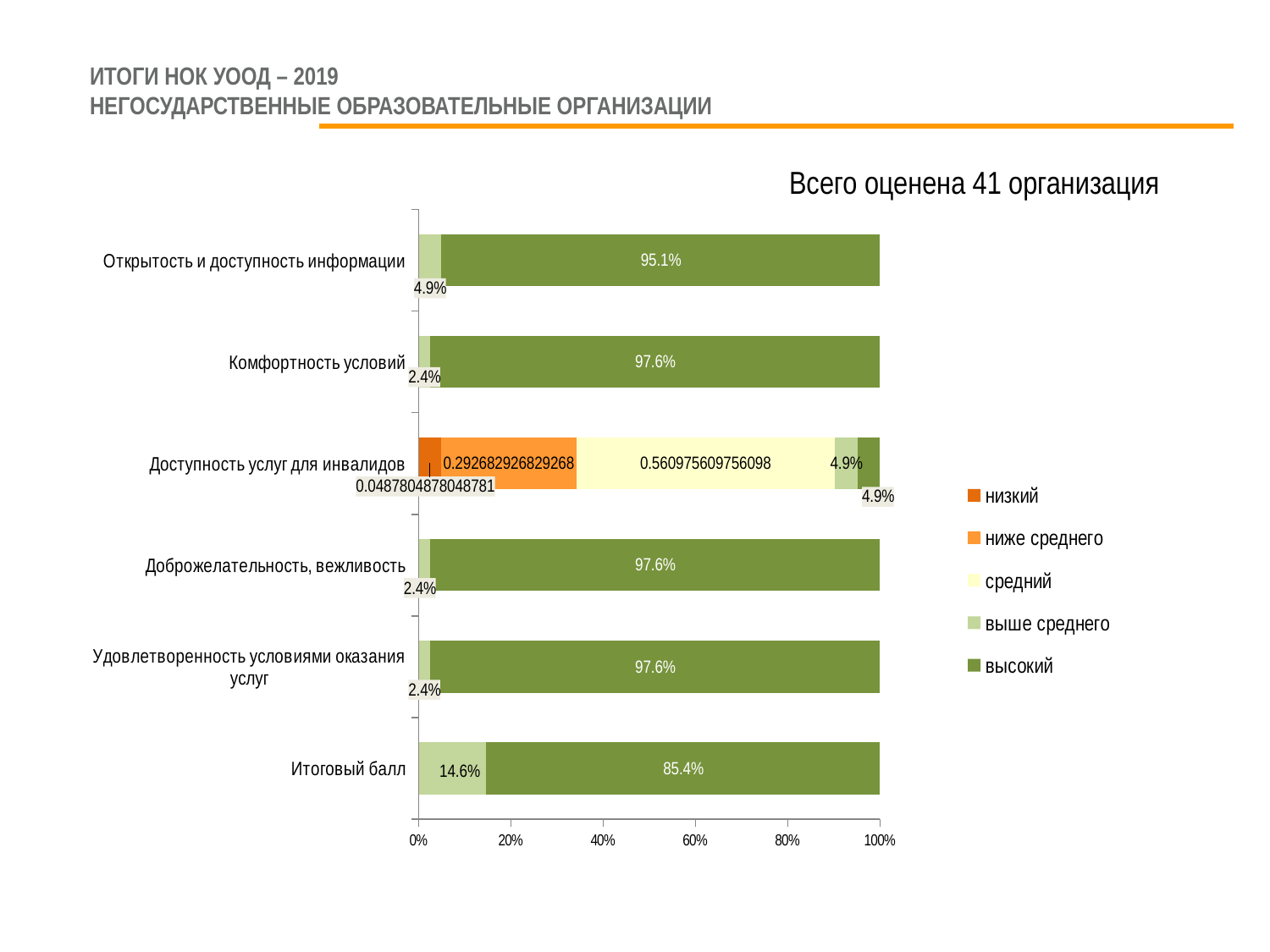
What is the value of the 'высокий' series for 'Комфортность условий'? 97.6% What is the value of the 'средний' series for 'Доступность услуг для инвалидов'? 0.560975609756098 What kind of chart is shown on the slide? stacked bar chart How many series does the legend list? 5 What is the value of the 'выше среднего' series for 'Итоговый балл'? 14.6% How many categories are plotted on the chart? 6 What is the value of the 'высокий' series for 'Открытость и доступность информации'? 95.1% Which is larger: the 'высокий' value for 'Открытость и доступность информации' or for 'Доброжелательность, вежливость'? Доброжелательность, вежливость What is the value of the 'ниже среднего' series for 'Доступность услуг для инвалидов'? 0.292682926829268 Which category has the lowest value for the 'высокий' series? Доступность услуг для инвалидов What is the difference between the 'высокий' values for 'Комфортность условий' and 'Итоговый балл'? 12.2% According to the text above the chart, how many organisations were evaluated in total? 41